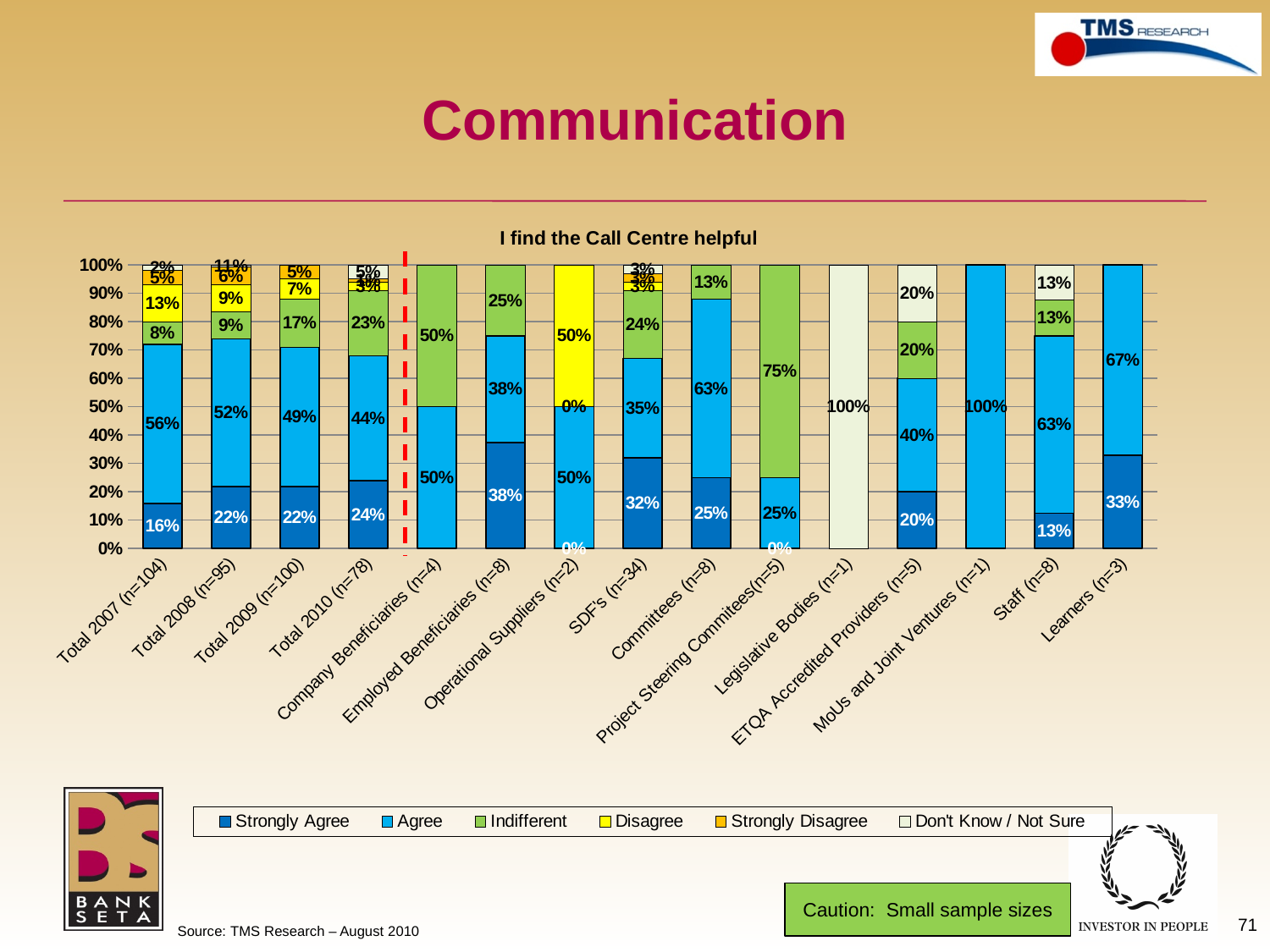
What type of chart is shown on the slide? Stacked bar chart How many series does the legend list? 6 What is the Strongly Agree value for Total 2007 (n=104)? 16% What is the Disagree value for Operational Suppliers (n=2)? 50% What is the Agree value for Total 2010 (n=78)? 44% What is the title of the chart? I find the Call Centre helpful What is the difference between the Agree values for Learners (n=3) and Staff (n=8)? 4% Which category has the highest Strongly Agree value? Employed Beneficiaries (n=8) What is the Indifferent value for Project Steering Committees (n=5)? 75% Which series makes up 100% of the bar for Legislative Bodies (n=1)? Don't Know / Not Sure Does the Strongly Agree value rise or fall from Total 2007 to Total 2010? Rise Which is larger, the Indifferent value for Total 2010 (n=78) or for Total 2009 (n=100)? Total 2010 (n=78)